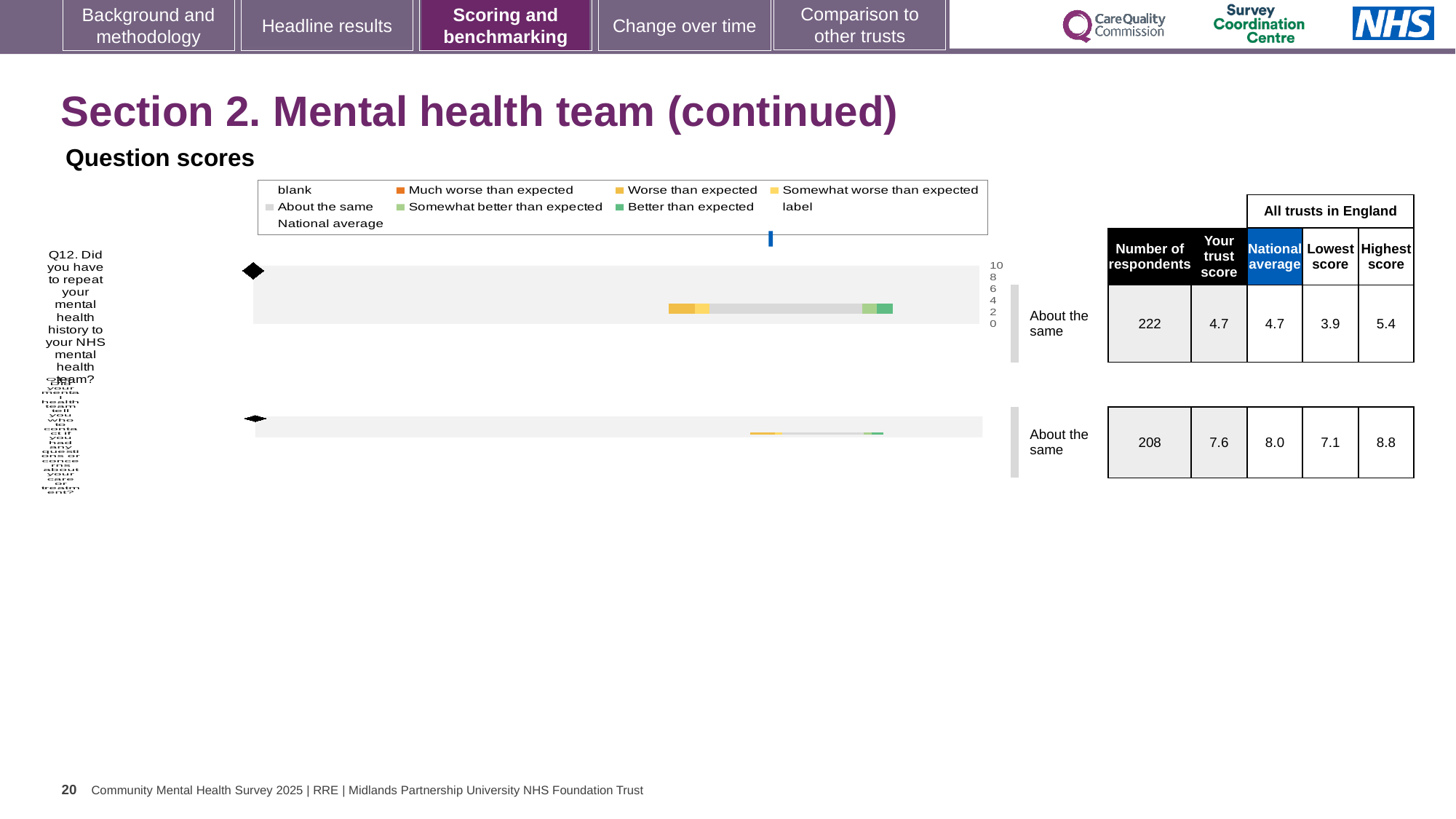
What is the national average score for Q12? 4.7 What is the highest score among all trusts in England for Q12? 5.4 How many questions are plotted in the question scores chart? 2 What is the difference between the highest and lowest trust scores for Q12? 1.5 What kind of chart is used to show the question scores? bar chart How many respondents answered Q12? 222 What is the trust score for Q12 (repeating mental health history to the NHS mental health team)? 4.7 For Q12, which is larger: the trust score or the highest score in England? Highest score How is the trust's result for Q12 categorised compared with other trusts? About the same What is the lowest score among all trusts in England for Q12? 3.9 Which legend entry is shown in orange? Much worse than expected What is the maximum value shown on the chart's score axis? 10